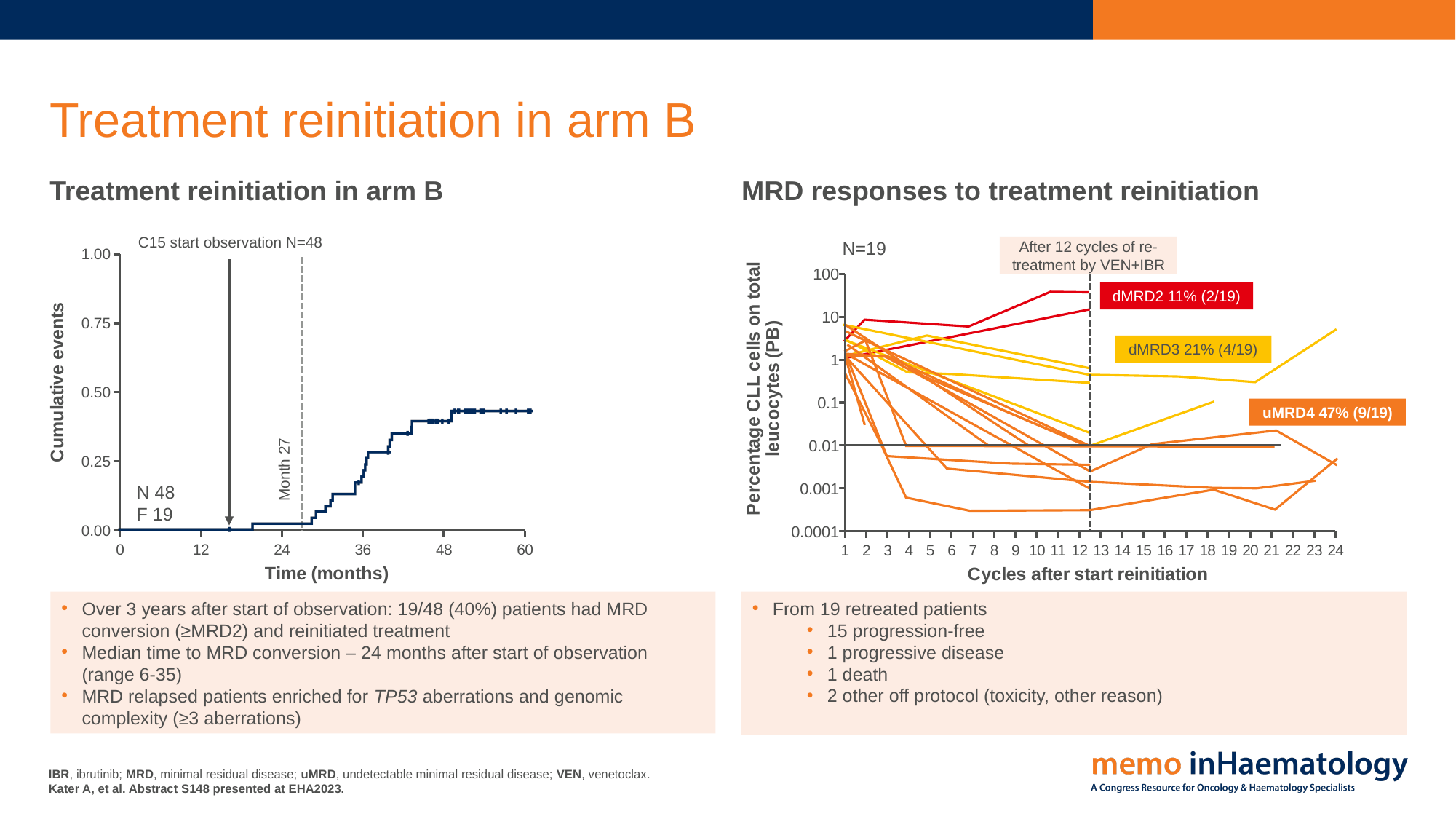
In the left chart 'Treatment reinitiation in arm B', is the cumulative events value at 24 months greater or less than 0.25? less In the left chart 'Treatment reinitiation in arm B', is the cumulative events value at 60 months greater or less than 0.50? less In the left chart 'Treatment reinitiation in arm B', what is the N at C15 start observation? 48 What kind of chart is the left chart titled 'Treatment reinitiation in arm B'? line chart In the right chart 'MRD responses to treatment reinitiation', how many patients (N) are plotted? 19 In the left chart 'Treatment reinitiation in arm B', do cumulative events rise or fall over time? rise In the left chart 'Treatment reinitiation in arm B', at which month is the dashed vertical line placed? Month 27 In the right chart 'MRD responses to treatment reinitiation', which MRD category has the largest share of patients? uMRD4 In the right chart 'MRD responses to treatment reinitiation', what percentage of patients achieved uMRD4? 47% (9/19) In the right chart 'MRD responses to treatment reinitiation', what percentage of patients had dMRD3? 21% (4/19) In the right chart 'MRD responses to treatment reinitiation', what percentage of patients had dMRD2? 11% (2/19) In the right chart 'MRD responses to treatment reinitiation', what is the label of the x axis? Cycles after start reinitiation